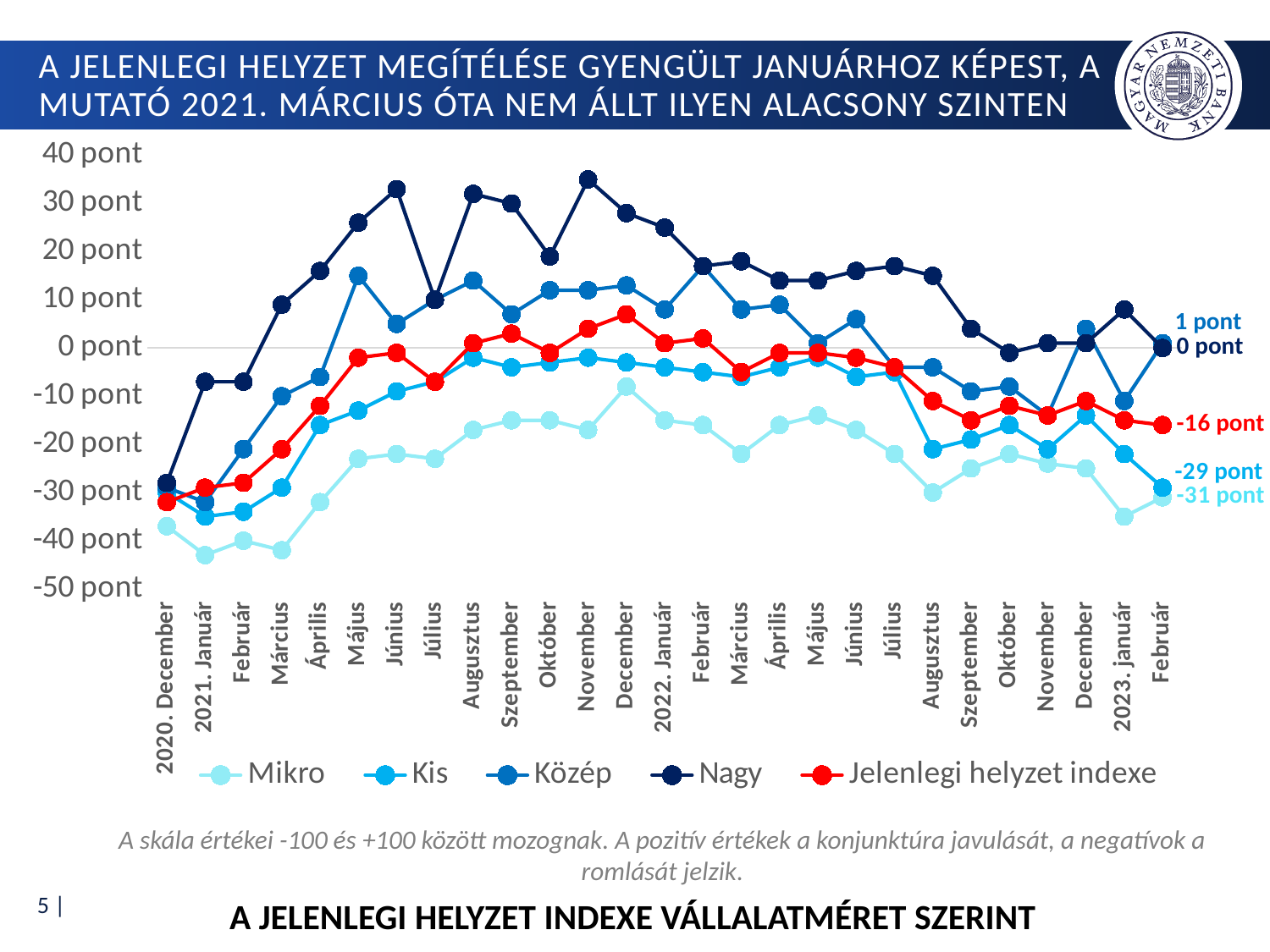
How many series does the legend list? 5 What is the value of the Mikro series in 2023 Február? -31 pont Which series has the highest value in 2023 Február? Közép Is the value for Nagy in 2021 Június greater or less than 30 pont? greater What is the value of the Jelenlegi helyzet indexe series in 2023 Február? -16 pont What kind of chart is shown on the slide? Line chart Which series has the lowest value in 2023 Február? Mikro What is the difference between the Kis and Mikro values in 2023 Február? 2 pont What is the value of the Nagy series in 2023 Február? 0 pont Does the Nagy series rise or fall from 2020 December to 2021 Június? Rise Is the value for Mikro in 2021 Január greater or less than -40 pont? less What is the value of the Közép series in 2023 Február? 1 pont